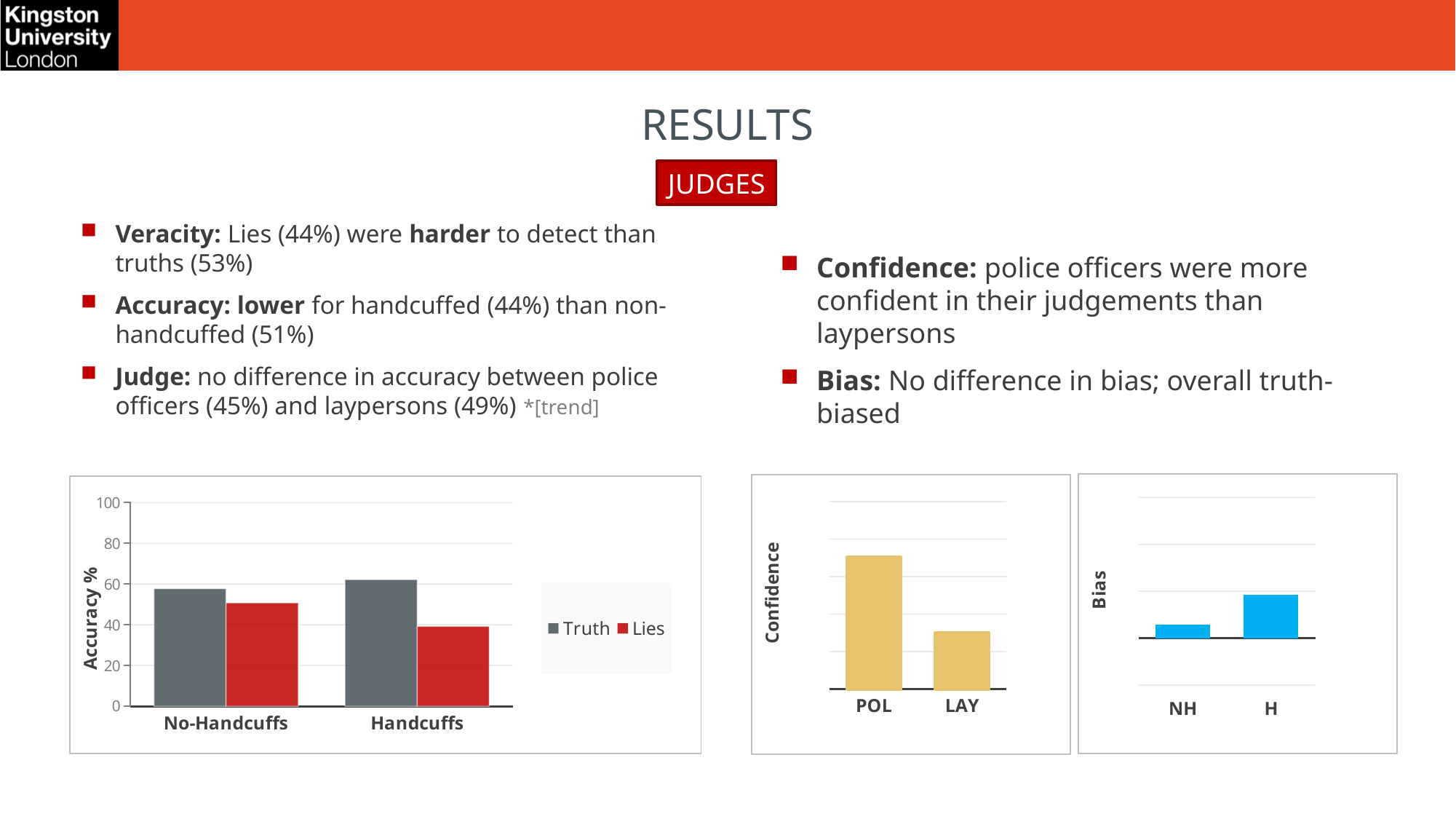
What kind of chart is the Accuracy % chart on the left? bar chart What is the y-axis label of the chart on the left? Accuracy % How many series does the legend of the Accuracy % chart list? 2 In the Accuracy % chart, which bar is the tallest? Truth for Handcuffs In the Accuracy % chart, is the Truth or the Lies bar larger for Handcuffs? Truth In the Accuracy % chart, is the value for Lies under No-Handcuffs greater or less than 40? greater In the Accuracy % chart, is the value for Lies under Handcuffs greater or less than 60? less In the Accuracy % chart, which bar is the shortest? Lies for Handcuffs In the Accuracy % chart, is the value for Truth under No-Handcuffs greater or less than 80? less In the Confidence chart, which category has the higher bar, POL or LAY? POL In the Bias chart, which category has the higher bar, NH or H? H How many categories are shown on the x axis of the Accuracy % chart? 2